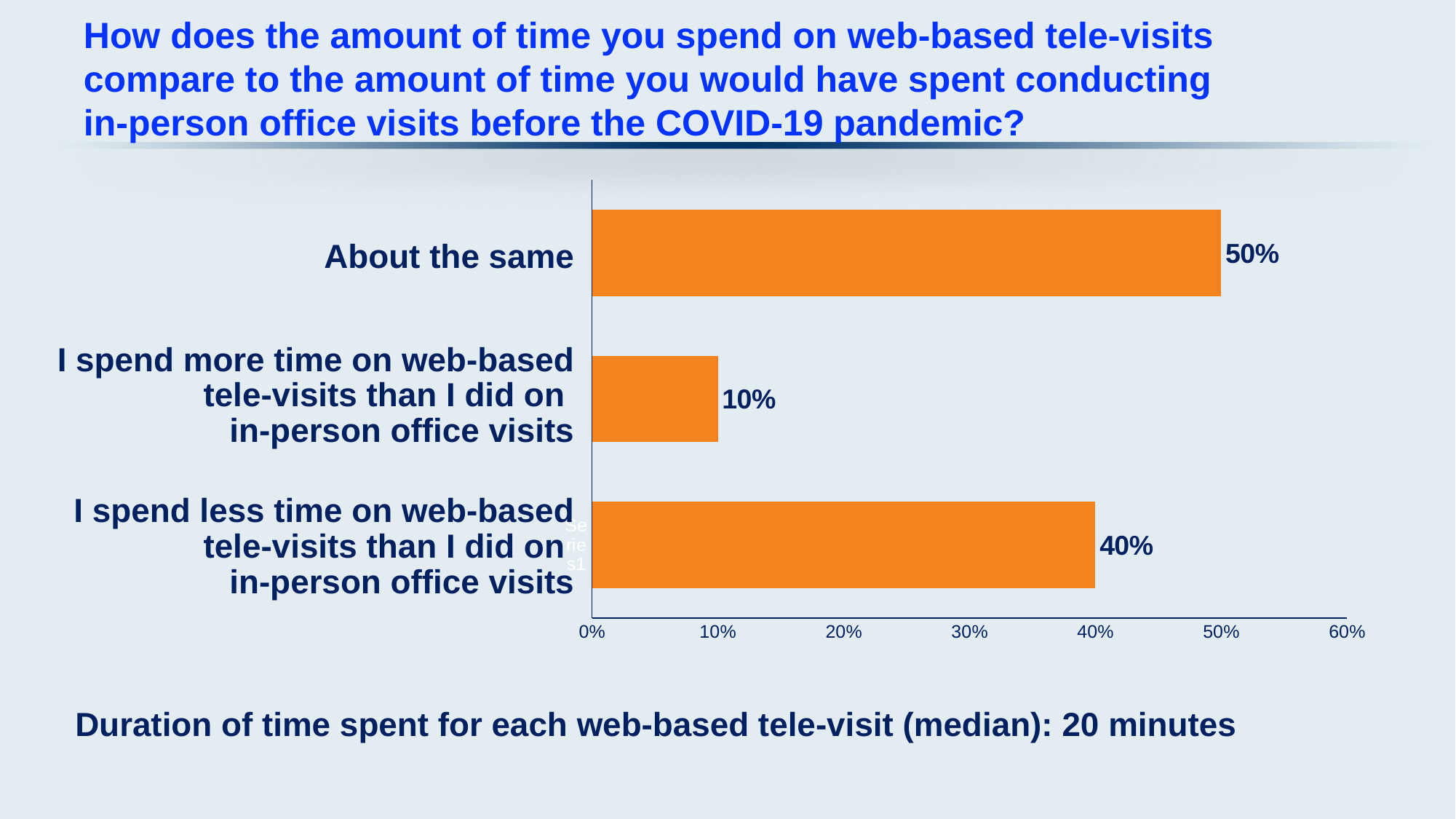
How many response categories are shown in the chart? 3 What is the difference in percentage points between 'About the same' and 'I spend less time on web-based tele-visits'? 10% Which response category has the highest percentage? About the same What type of chart is shown on the slide? Bar chart Which response category has the lowest percentage? I spend more time on web-based tele-visits than I did on in-person office visits What percentage of respondents said they spend less time on web-based tele-visits than on in-person office visits? 40% What is the maximum value shown on the horizontal axis? 60% Which is larger: the percentage for 'I spend less time on web-based tele-visits' or 'I spend more time on web-based tele-visits'? I spend less time on web-based tele-visits than I did on in-person office visits What is the difference in percentage points between 'I spend less time' and 'I spend more time' on web-based tele-visits? 30% What percentage of respondents said they spend more time on web-based tele-visits than on in-person office visits? 10% What is the median duration of time spent for each web-based tele-visit stated on the slide? 20 minutes What percentage of respondents said the time spent is 'About the same'? 50%